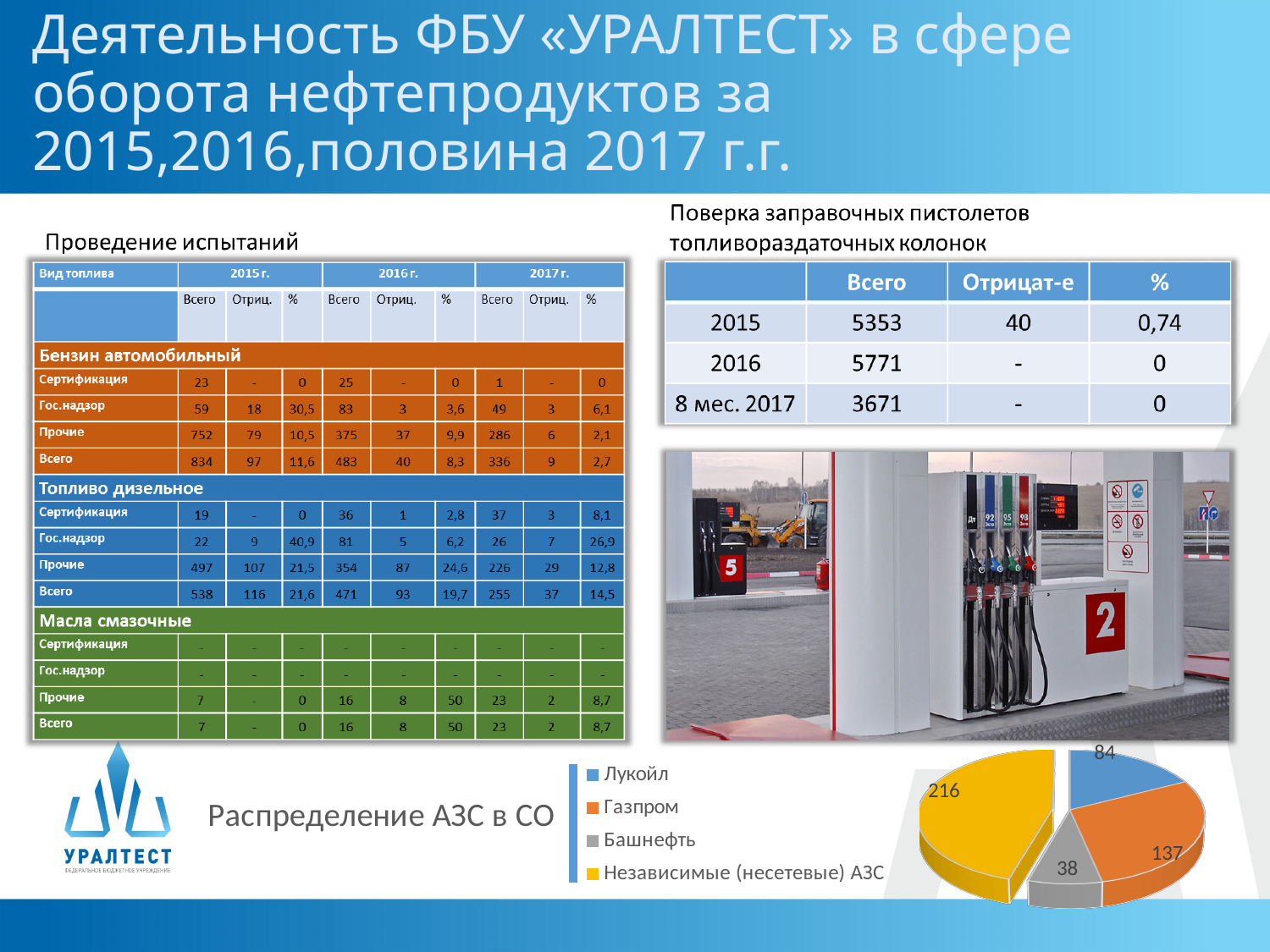
In the pie chart Распределение АЗС в СО, which category has the smallest slice? Башнефть In the pie chart Распределение АЗС в СО, what is the difference between the values for Газпром and Лукойл? 53 In the pie chart Распределение АЗС в СО, what colour is the slice for Независимые (несетевые) АЗС? yellow In the pie chart Распределение АЗС в СО, which category has the largest slice? Независимые (несетевые) АЗС In the pie chart Распределение АЗС в СО, what is the value for Независимые (несетевые) АЗС? 216 In the pie chart Распределение АЗС в СО, what is the total of all four slices? 475 In the pie chart Распределение АЗС в СО, what is the value for Газпром? 137 In the pie chart Распределение АЗС в СО, which is larger: Лукойл or Газпром? Газпром How many categories does the legend of the pie chart Распределение АЗС в СО list? 4 In the pie chart Распределение АЗС в СО, what is the value for Башнефть? 38 What kind of chart is shown at the bottom right of the slide (Распределение АЗС в СО)? pie chart In the pie chart Распределение АЗС в СО, what is the value for Лукойл? 84